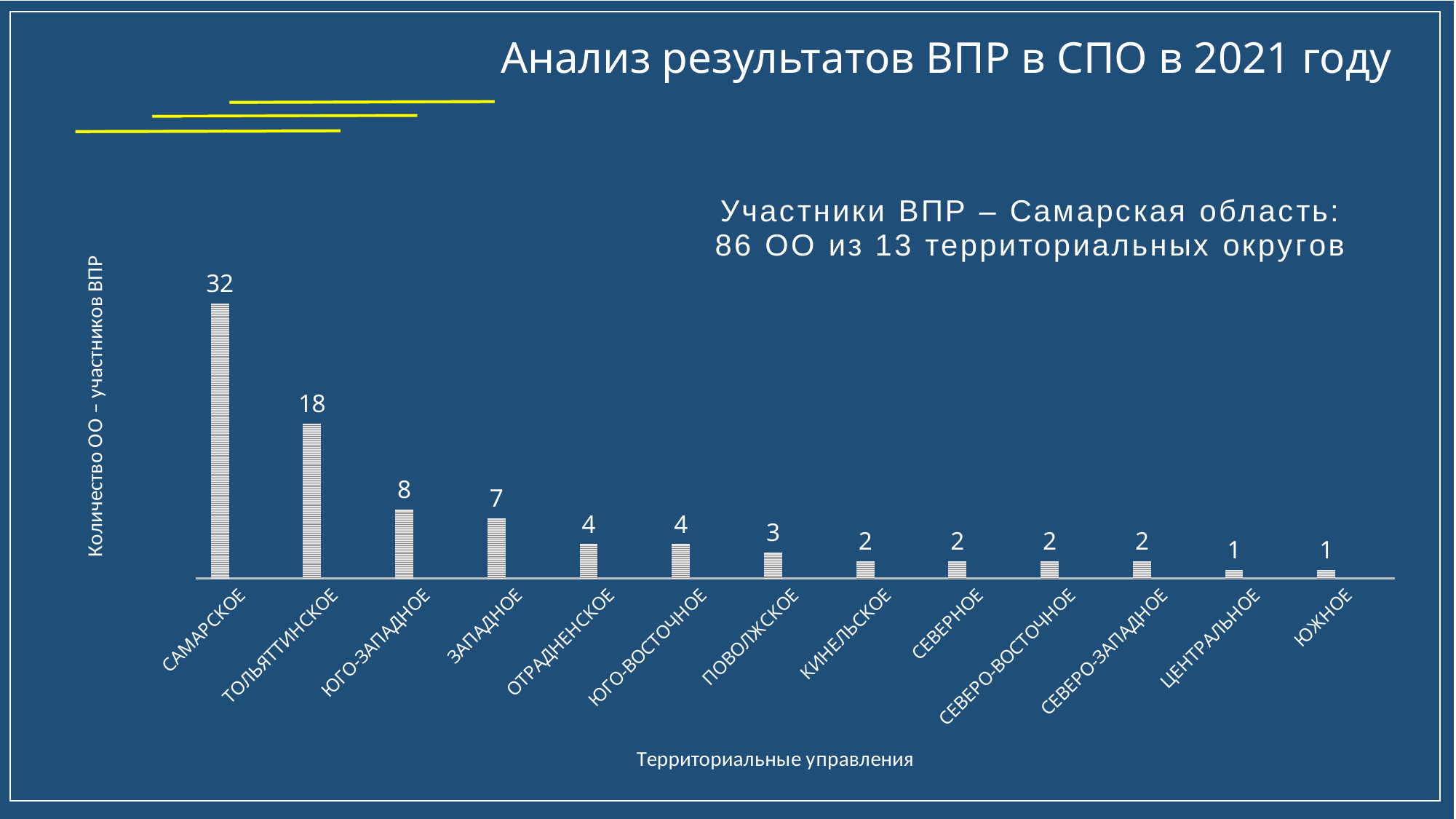
How many territorial administrations are shown on the x axis? 13 Do the values rise or fall from left to right along the x axis? Fall What is the value for ЗАПАДНОЕ? 7 Which is larger, the value for ЮГО-ЗАПАДНОЕ or the value for ЗАПАДНОЕ? ЮГО-ЗАПАДНОЕ What is the value for ПОВОЛЖСКОЕ? 3 Which territorial administrations have the lowest value? ЦЕНТРАЛЬНОЕ and ЮЖНОЕ What is the difference between the values for САМАРСКОЕ and ТОЛЬЯТТИНСКОЕ? 14 What is the label of the vertical axis? Количество ОО – участников ВПР What kind of chart is shown on the slide? Bar chart What is the value for ТОЛЬЯТТИНСКОЕ? 18 Which territorial administration has the highest value? САМАРСКОЕ What is the value for САМАРСКОЕ? 32